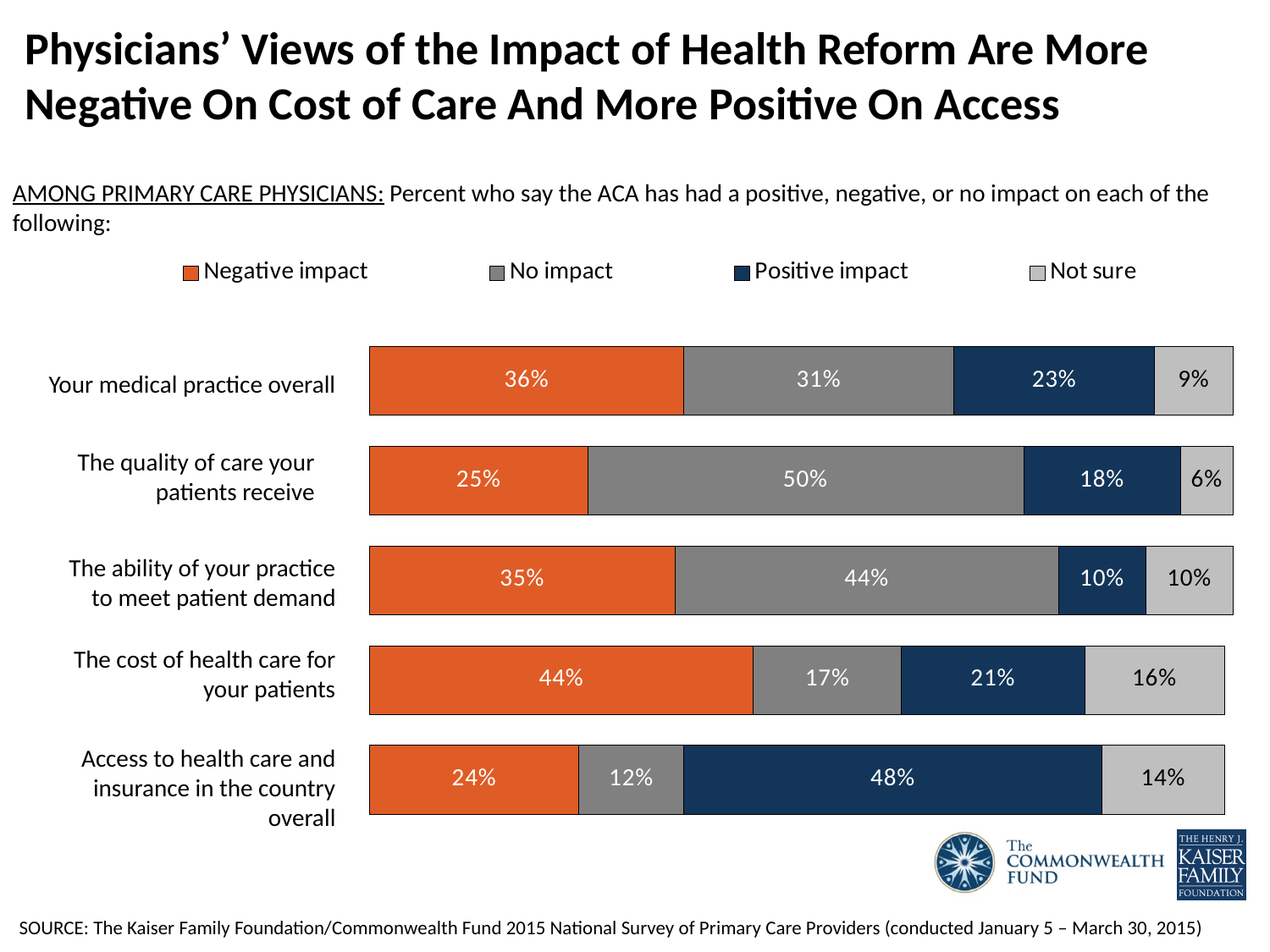
How many series does the legend list? 4 What percent say the ACA has had a positive impact on access to health care and insurance in the country overall? 48% What percent are not sure about the ACA's impact on the ability of their practice to meet patient demand? 10% Is the positive impact share larger for 'Access to health care and insurance in the country overall' or for 'The cost of health care for your patients'? Access to health care and insurance in the country overall Which item has the highest share of physicians reporting a negative impact? The cost of health care for your patients What percent say the ACA has had no impact on the quality of care their patients receive? 50% What percent of primary care physicians say the ACA has had a negative impact on the cost of health care for their patients? 44% How many items are shown on the chart? 5 Which colour represents 'Positive impact' in the chart? Dark blue Which item has the lowest share of physicians reporting a positive impact? The ability of your practice to meet patient demand What kind of chart is shown on the slide? Stacked bar chart What is the difference between the negative impact and positive impact percentages for 'Your medical practice overall'? 13 percentage points